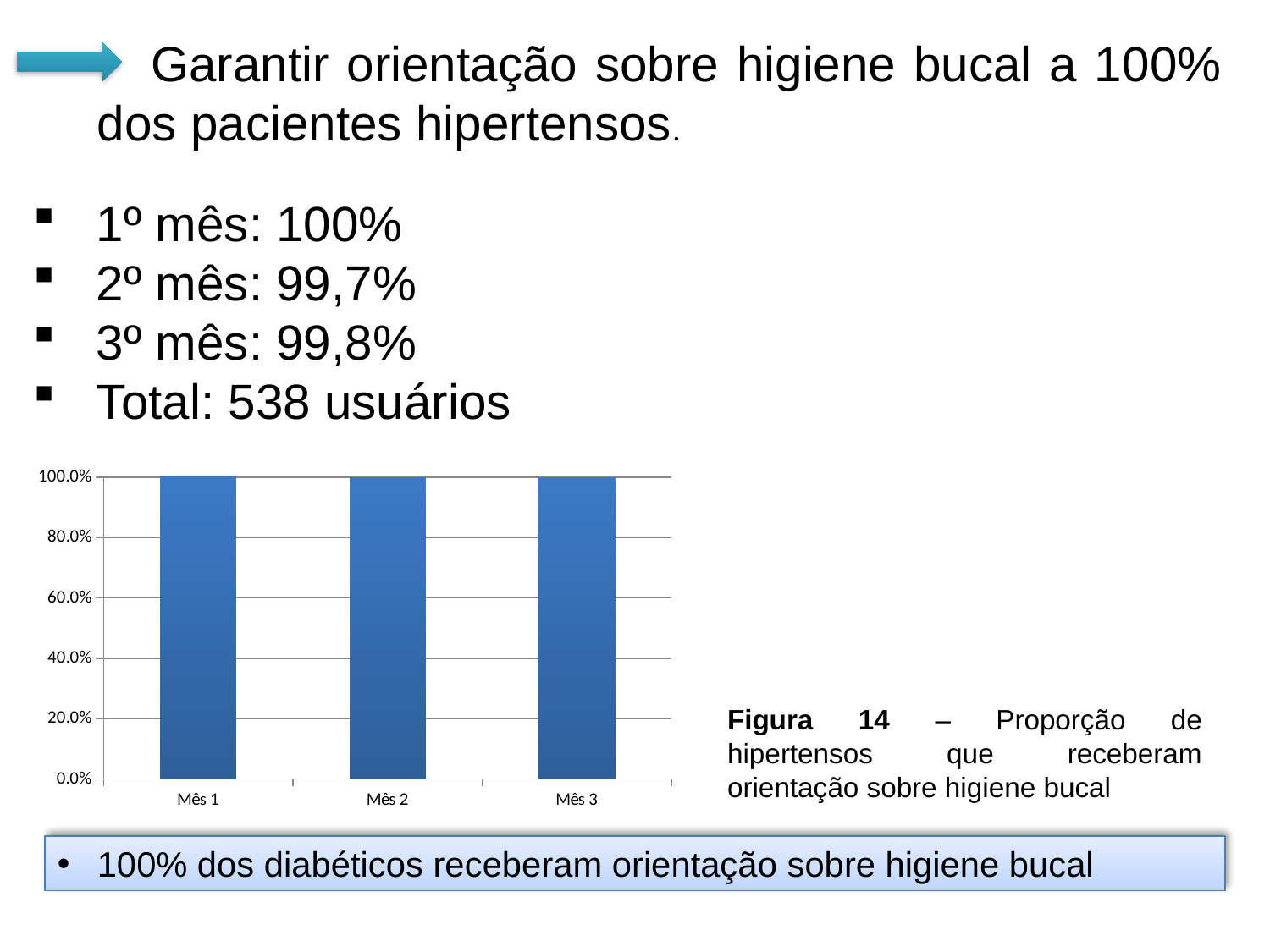
What is the lowest tick value shown on the y axis of the chart? 0.0% What is the highest tick value shown on the y axis of the chart? 100.0% Is the value for Mês 3 greater or less than 60.0%? greater What value does the bar for Mês 1 reach on the y axis? 100.0% What are the category labels on the x axis of the chart? Mês 1, Mês 2, Mês 3 Is the value for Mês 1 greater or less than 40.0%? greater According to the figure caption, what is the figure number of the chart? Figura 14 Is the value for Mês 2 greater or less than 80.0%? greater What kind of chart is shown on the slide? bar chart How many bars (categories) does the chart show? 3